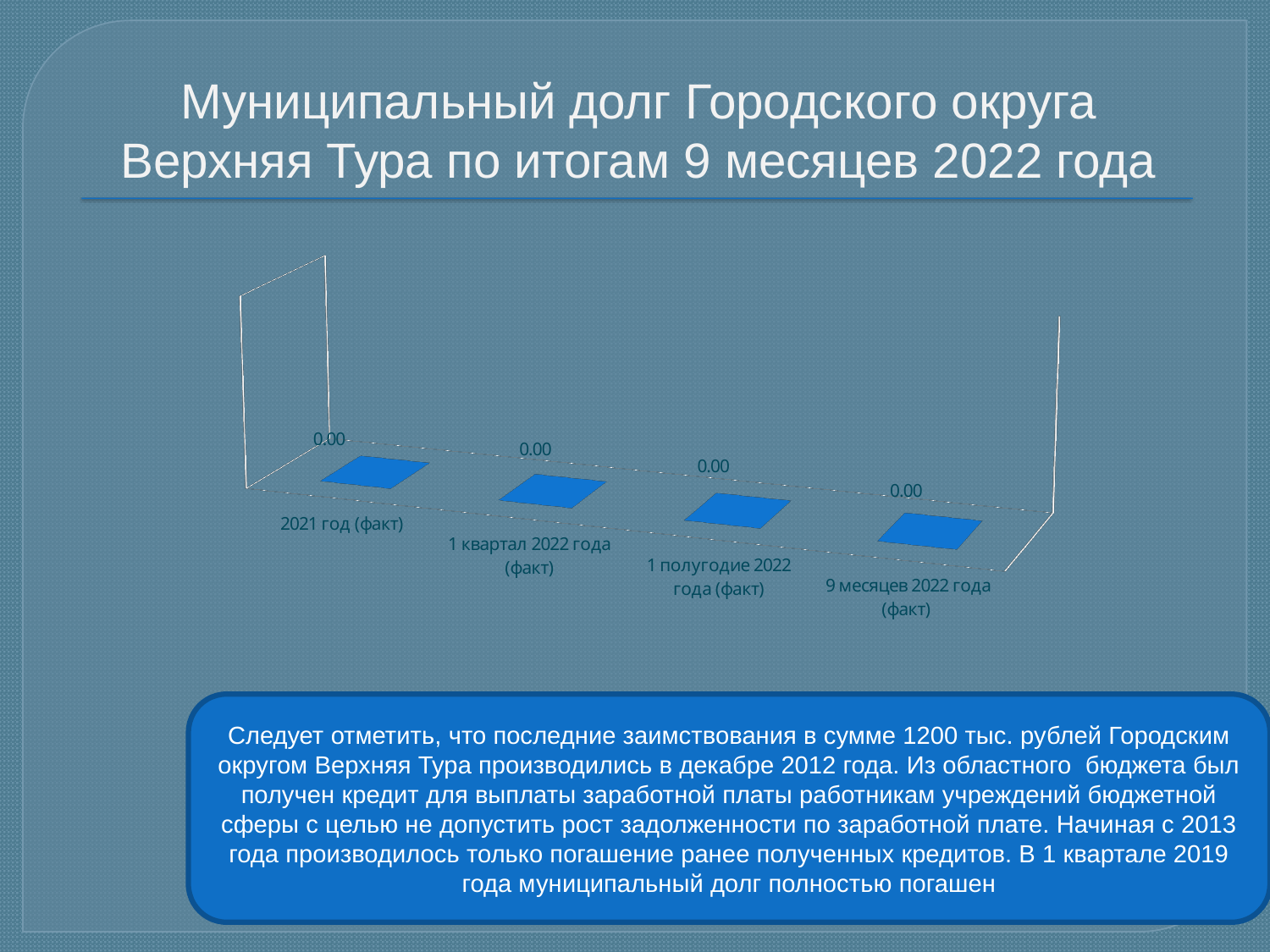
Do the values rise, fall, or stay the same from 2021 год (факт) to 9 месяцев 2022 года (факт)? Stay the same What is the value shown for 9 месяцев 2022 года (факт)? 0.00 Is the value for 1 квартал 2022 года (факт) larger than, smaller than, or equal to the value for 1 полугодие 2022 года (факт)? Equal What is the value shown for 2021 год (факт)? 0.00 What is the value shown for 1 полугодие 2022 года (факт)? 0.00 What is the label of the first (leftmost) category on the chart? 2021 год (факт) What kind of chart is shown on the slide? Bar chart What is the label of the last (rightmost) category on the chart? 9 месяцев 2022 года (факт) What is the value shown for 1 квартал 2022 года (факт)? 0.00 What is the difference between the values for 2021 год (факт) and 9 месяцев 2022 года (факт)? 0.00 How many categories are plotted on the chart? 4